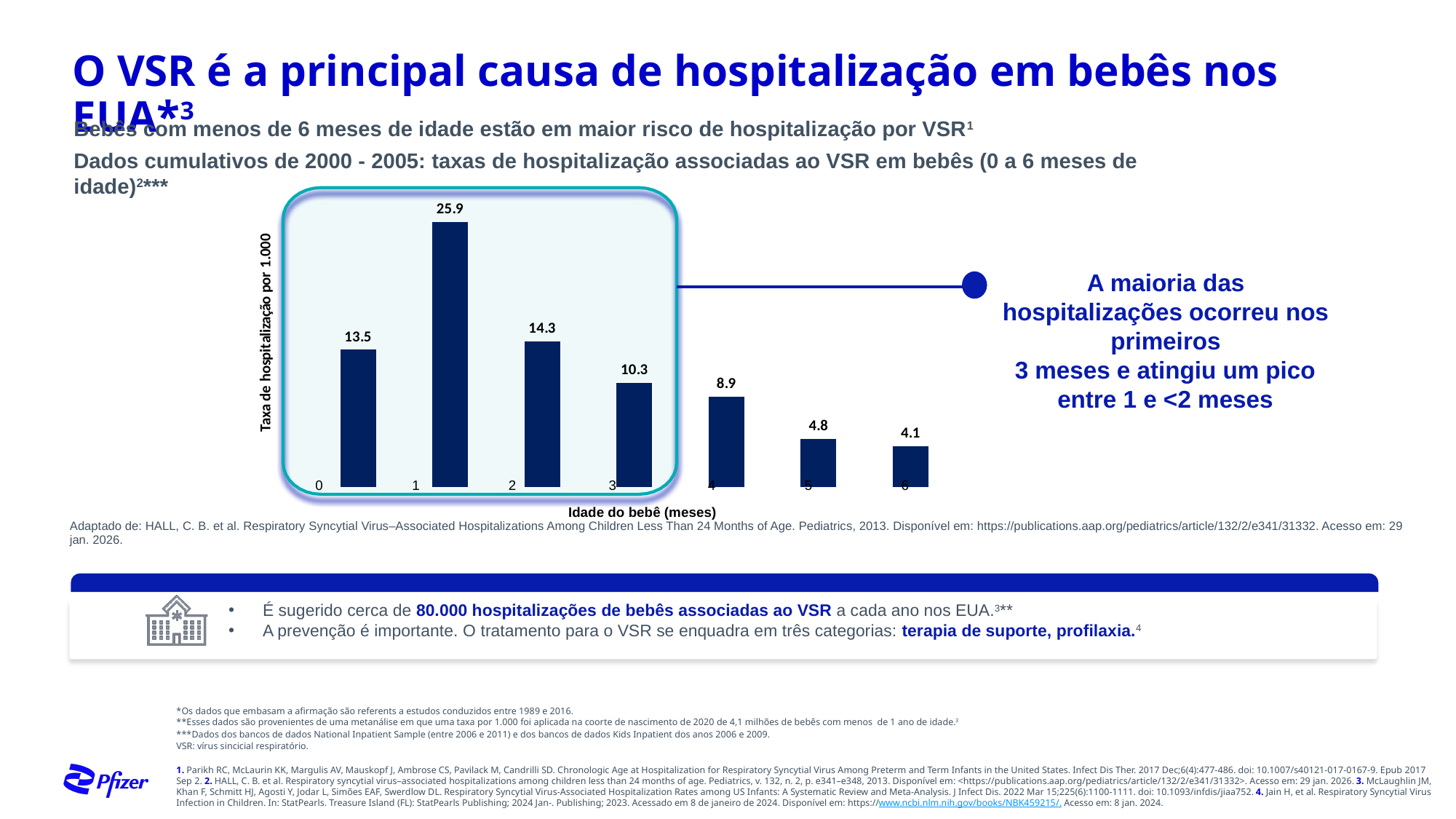
What is the hospitalization rate per 1,000 for babies aged 1 month? 25.9 What is the hospitalization rate per 1,000 for babies aged 6 months? 4.1 What is the hospitalization rate per 1,000 for babies aged 0 months? 13.5 Which age in months has the highest hospitalization rate? 1 What kind of chart is shown on the slide? Bar chart Which age in months has the lowest hospitalization rate? 6 What is the difference between the hospitalization rates at 3 months and 5 months? 5.5 What is the difference between the hospitalization rates at 1 month and 2 months? 11.6 How many age categories are shown on the x axis? 7 What is the hospitalization rate per 1,000 for babies aged 4 months? 8.9 What is the label of the x axis of the chart? Idade do bebê (meses) Which has a higher hospitalization rate, 0 months or 2 months? 2 months